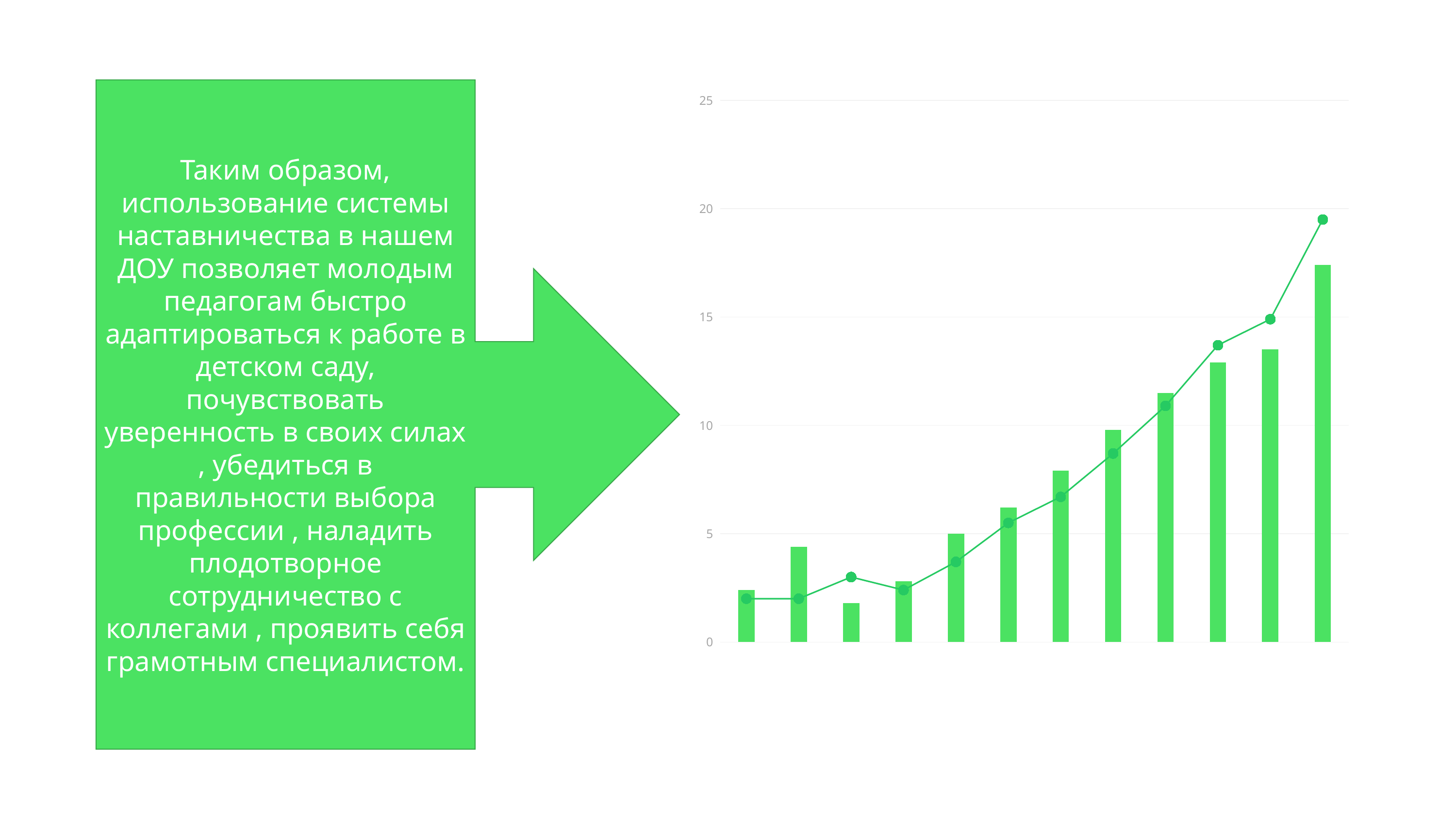
Is the last point on the line greater or less than 15? greater Is the value of the rightmost bar greater or less than 15? greater Is the value of the leftmost bar greater or less than 5? less What colour are the bars in the chart? Green How many bars are plotted in the chart? 12 What is the highest value shown on the vertical axis? 25 Which bar is the shortest in the chart? The third bar from the left What kind of chart is shown on the slide? A combined bar and line chart Do the bar values generally rise or fall from left to right along the x axis? Rise Which bar is the tallest in the chart? The rightmost (last) bar Which is larger, the leftmost bar or the rightmost bar? The rightmost bar